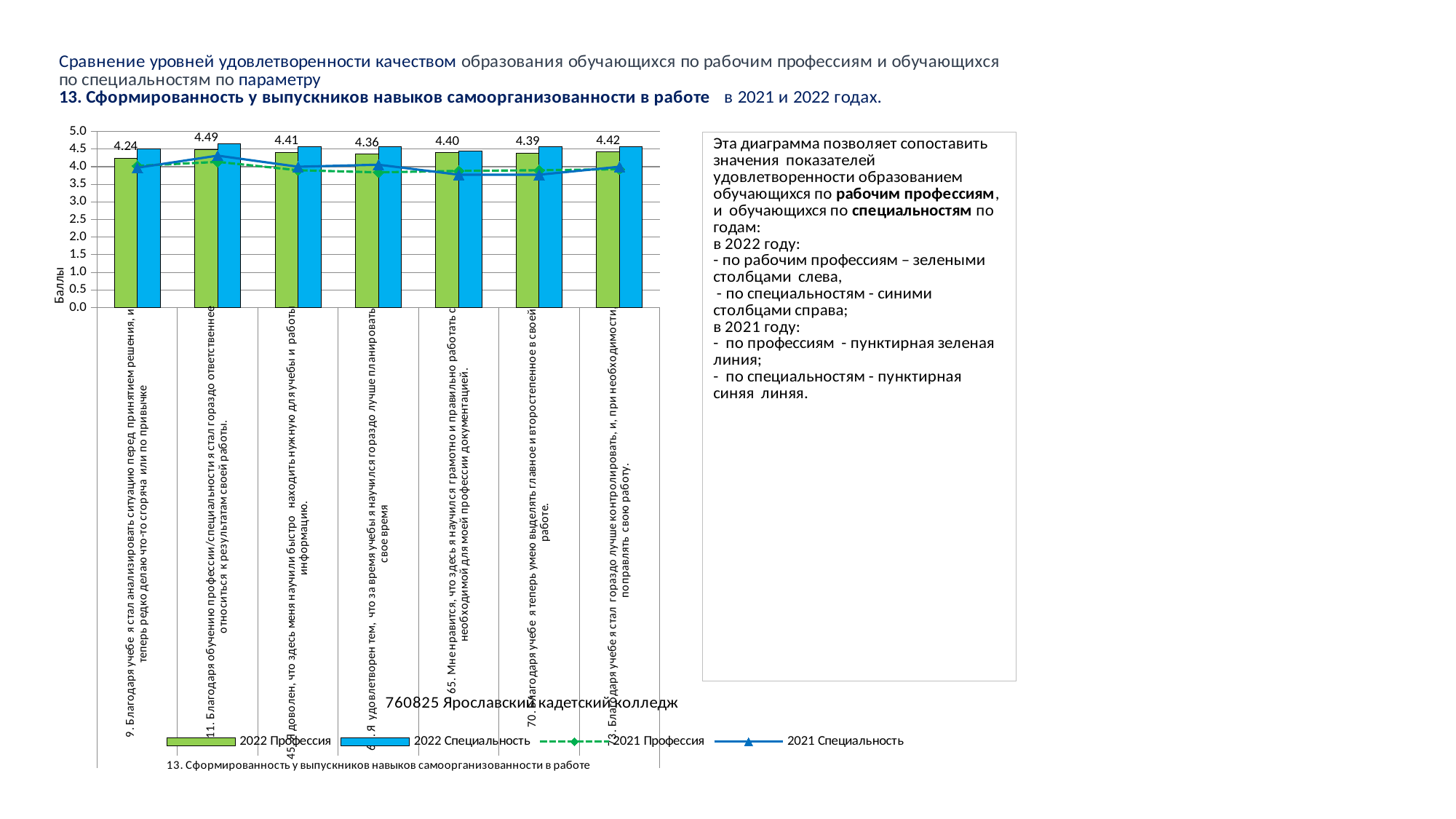
What is the difference between the 2022 Профессия values for question 11 and question 9? 0.25 Is the 2022 Специальность value for question 9 greater or less than 4.0? greater What kind of chart is shown? bar chart combined with line chart How many questions (categories) are shown on the x axis? 7 How many series does the legend list? 4 What is the 2022 Профессия value for question 9 (Благодаря учебе я стал анализировать ситуацию перед принятием решения)? 4.24 Which question has the highest labelled 2022 Профессия value? 11 (4.49) What is the 2022 Профессия value for question 11 (Благодаря обучению профессии/специальности я стал гораздо ответственнее)? 4.49 Is the 2021 Специальность value for question 65 greater or less than 4.0? less Which question has the lowest labelled 2022 Профессия value? 9 (4.24) What is the label on the vertical axis? Баллы